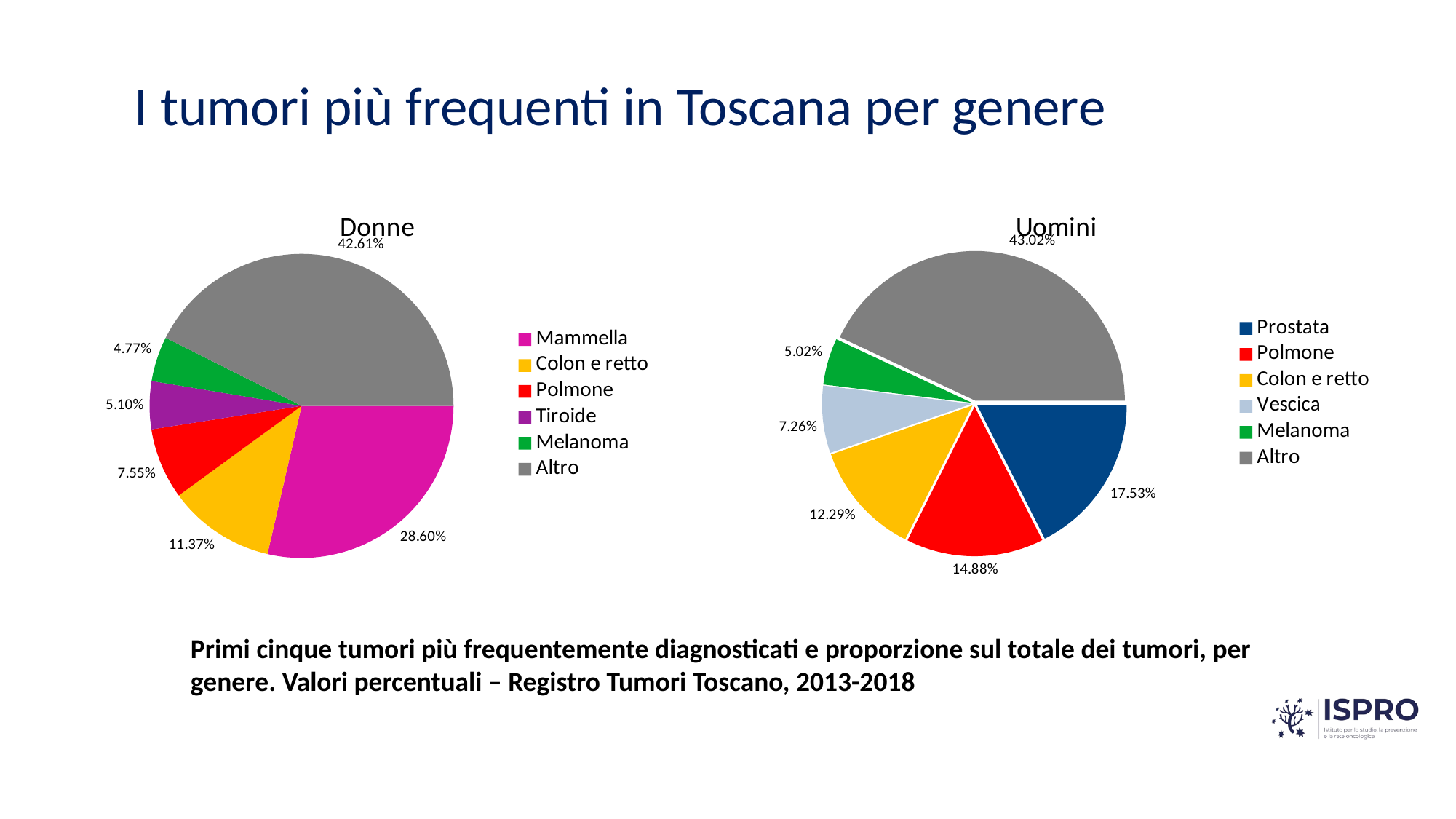
How many slices does the Uomini chart have? 6 In the Donne chart, which category has the largest slice? Altro In the Donne chart, what colour is the Melanoma slice? Green In the Donne chart, what percentage is shown for Mammella? 28.60% In the Uomini chart, what percentage is shown for Vescica? 7.26% In the Uomini chart, which is larger, Polmone or Colon e retto? Polmone In the Donne chart, what is the difference between the Mammella and Colon e retto percentages? 17.23% In the Donne chart, what percentage is shown for Tiroide? 5.10% In the Uomini chart, what is the difference between the Altro and Prostata percentages? 25.49% What kind of chart is the Donne chart? Pie chart In the Uomini chart, which category has the smallest slice? Melanoma In the Uomini chart, what percentage is shown for Prostata? 17.53%